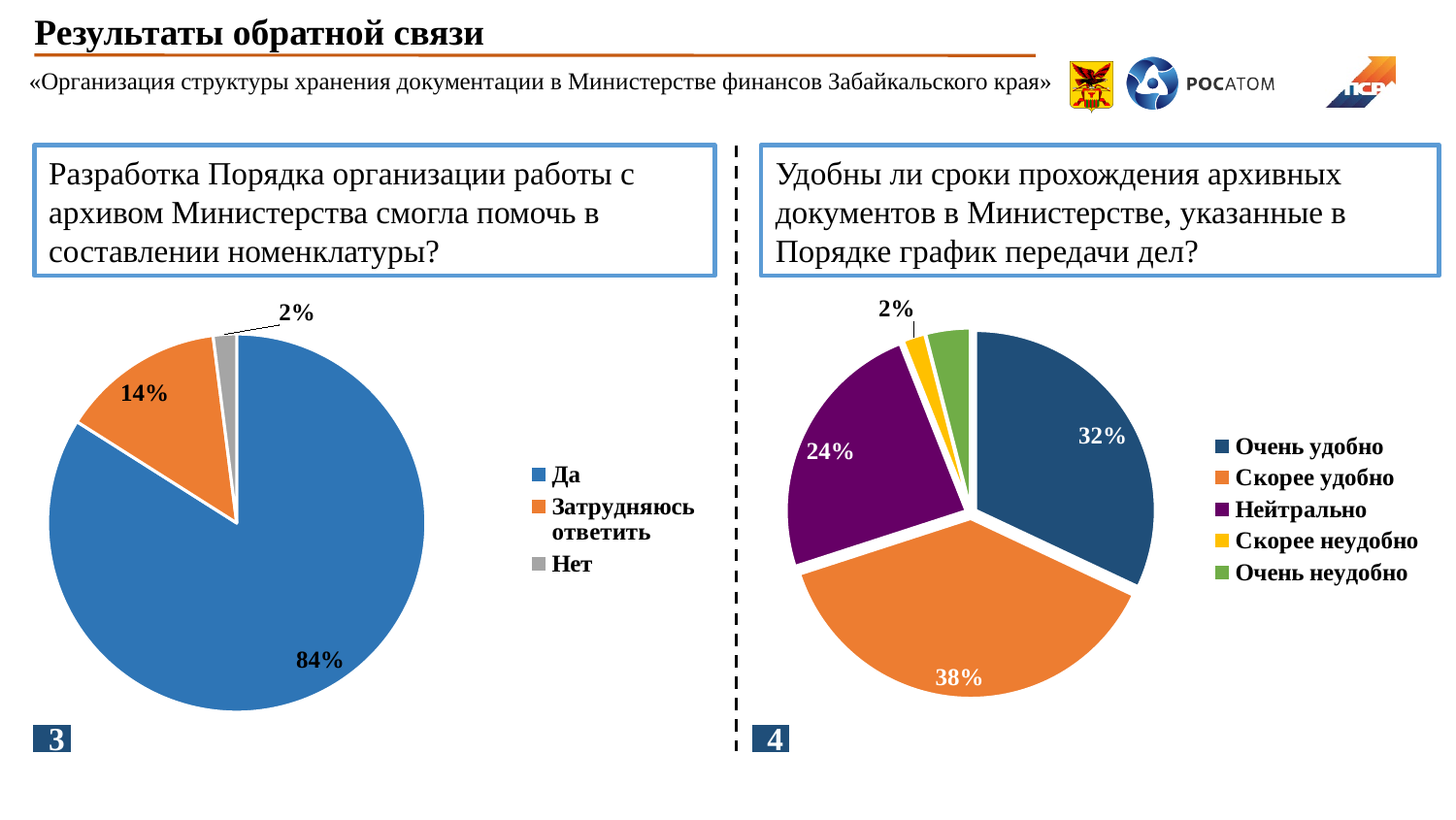
On the right pie chart, which answer has the largest share? Скорее удобно On the left pie chart, how many categories does the legend list? 3 On the right pie chart, what share of respondents answered "Скорее удобно"? 38% On the left pie chart, what share of respondents answered "Да"? 84% On the left pie chart, which answer has the largest share? Да What type of chart is used on the right side of the slide? Pie chart On the left pie chart, what share of respondents answered "Затрудняюсь ответить"? 14% On the right pie chart, what share of respondents answered "Нейтрально"? 24% On the left pie chart, what share of respondents answered "Нет"? 2% On the right pie chart, what share of respondents answered "Очень удобно"? 32% On the right pie chart, how many categories does the legend list? 5 On the left pie chart, what is the difference in percentage points between "Да" and "Затрудняюсь ответить"? 70